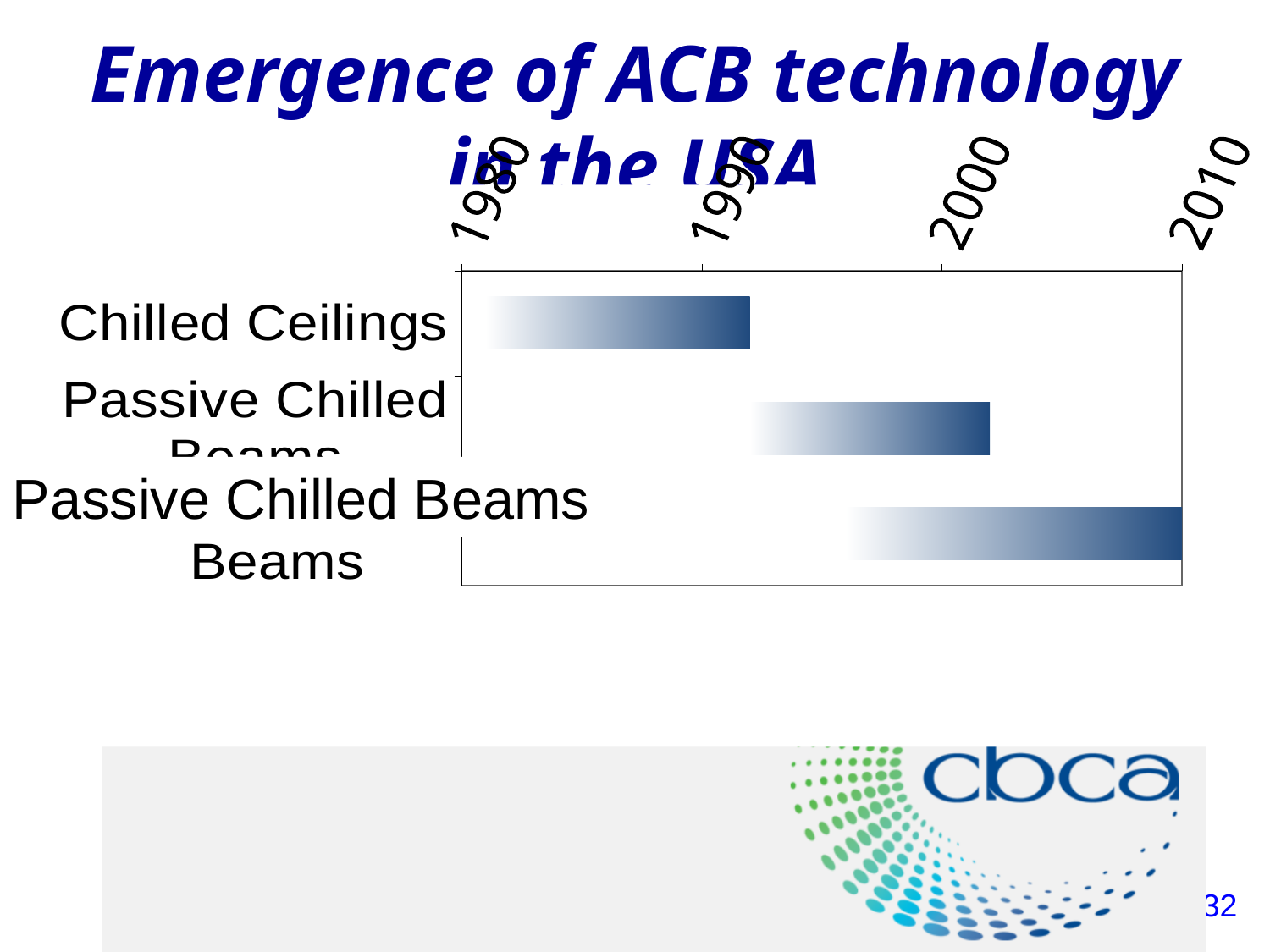
What kind of chart is shown on the slide? bar chart Going down the chart from the top bar to the bottom bar, do the bars start progressively earlier or later? later Which years are labelled on the x axis of the chart? 1980, 1990, 2000, 2010 Does the bar for Chilled Ceilings extend past 1990? yes Which category's bar starts earliest on the timeline? Chilled Ceilings Does the bar for Chilled Ceilings start before or after 1990? before How many bars are plotted in the chart? 3 What is the title of the slide containing the chart? Emergence of ACB technology in the USA Does the bar for Passive Chilled Beams end before or after 2000? after Which starts later on the timeline, Chilled Ceilings or Passive Chilled Beams? Passive Chilled Beams